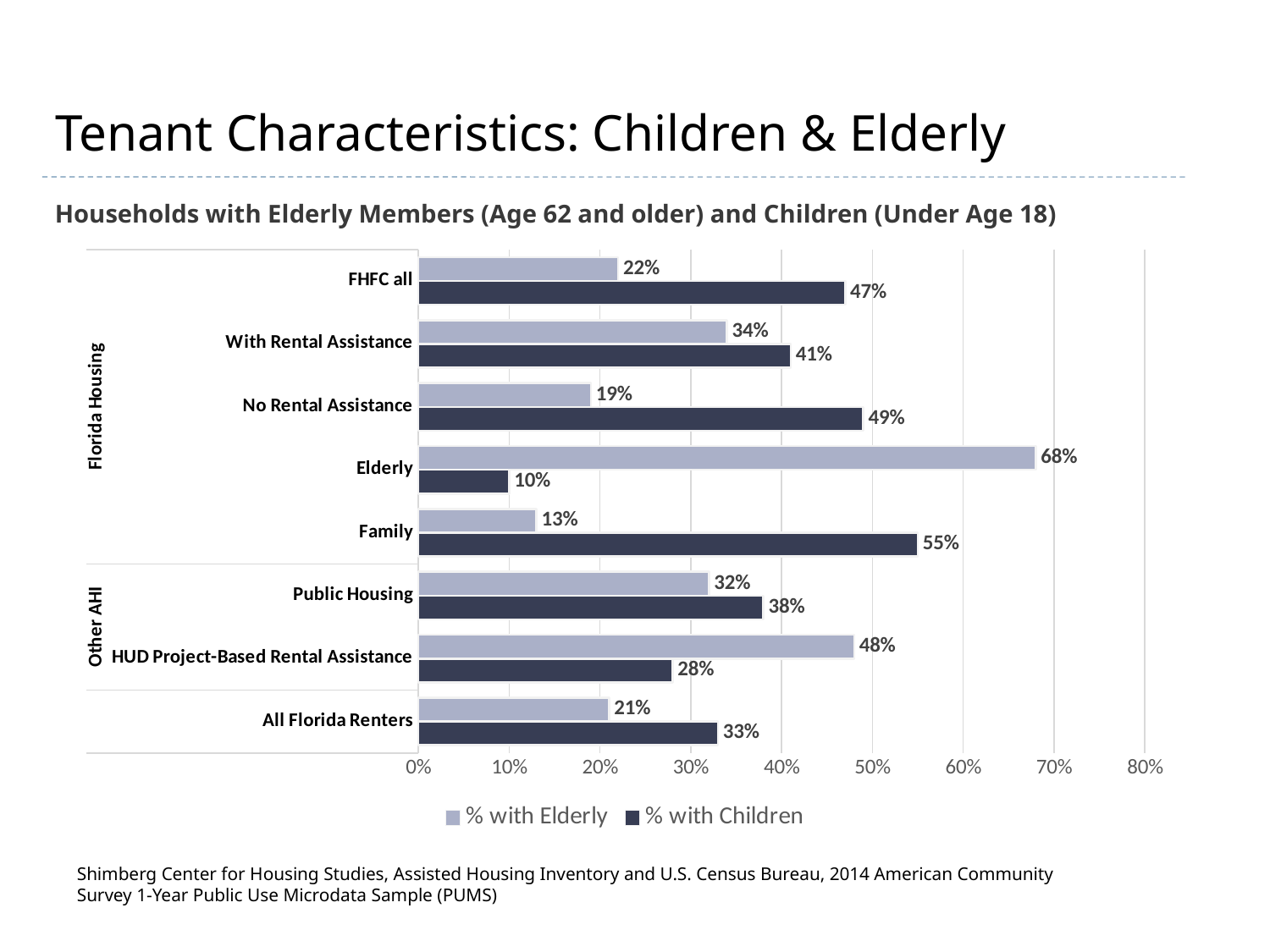
What kind of chart is shown on the slide? Bar chart What is the % with Children value for All Florida Renters? 33% Which category has the highest % with Elderly? Elderly What is the % with Elderly value for the Elderly category? 68% What is the difference between the % with Children and the % with Elderly for FHFC all? 25% For HUD Project-Based Rental Assistance, which is larger: % with Elderly or % with Children? % with Elderly Which category has the lowest % with Children? Elderly What is the title of the chart? Households with Elderly Members (Age 62 and older) and Children (Under Age 18) What is the % with Children value for Family? 55% How many categories are shown on the chart? 8 How many series does the legend list? 2 Is the % with Children value for No Rental Assistance greater or less than 40%? greater